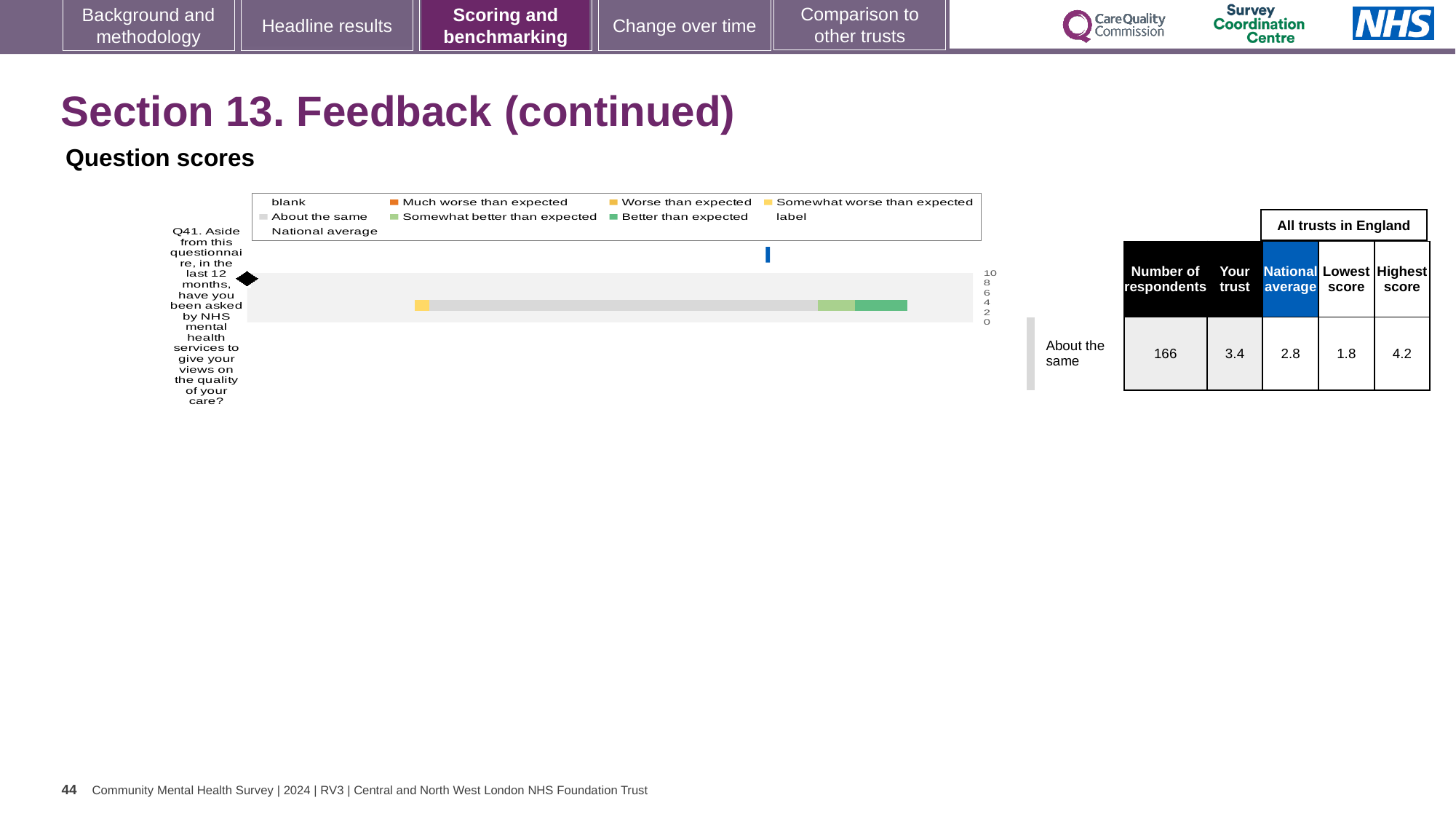
How many entries does the chart legend list? 9 What kind of chart is shown on the slide? bar chart How many questions are plotted in the chart? 1 According to the table, what is the highest score among all trusts in England for Q41? 4.2 Which benchmark category is the trust's Q41 result placed in? About the same According to the table, what is the lowest score among all trusts in England for Q41? 1.8 According to the table, what is the national average score for Q41? 2.8 Which is larger for Q41, the 'Your trust' score or the national average? Your trust What is the difference between the 'Your trust' score and the national average for Q41? 0.6 How many respondents answered Q41? 166 Which question is plotted in the chart? Q41. Aside from this questionnaire, in the last 12 months, have you been asked by NHS mental health services to give your views on the quality of your care? According to the table, what is the 'Your trust' score for Q41? 3.4